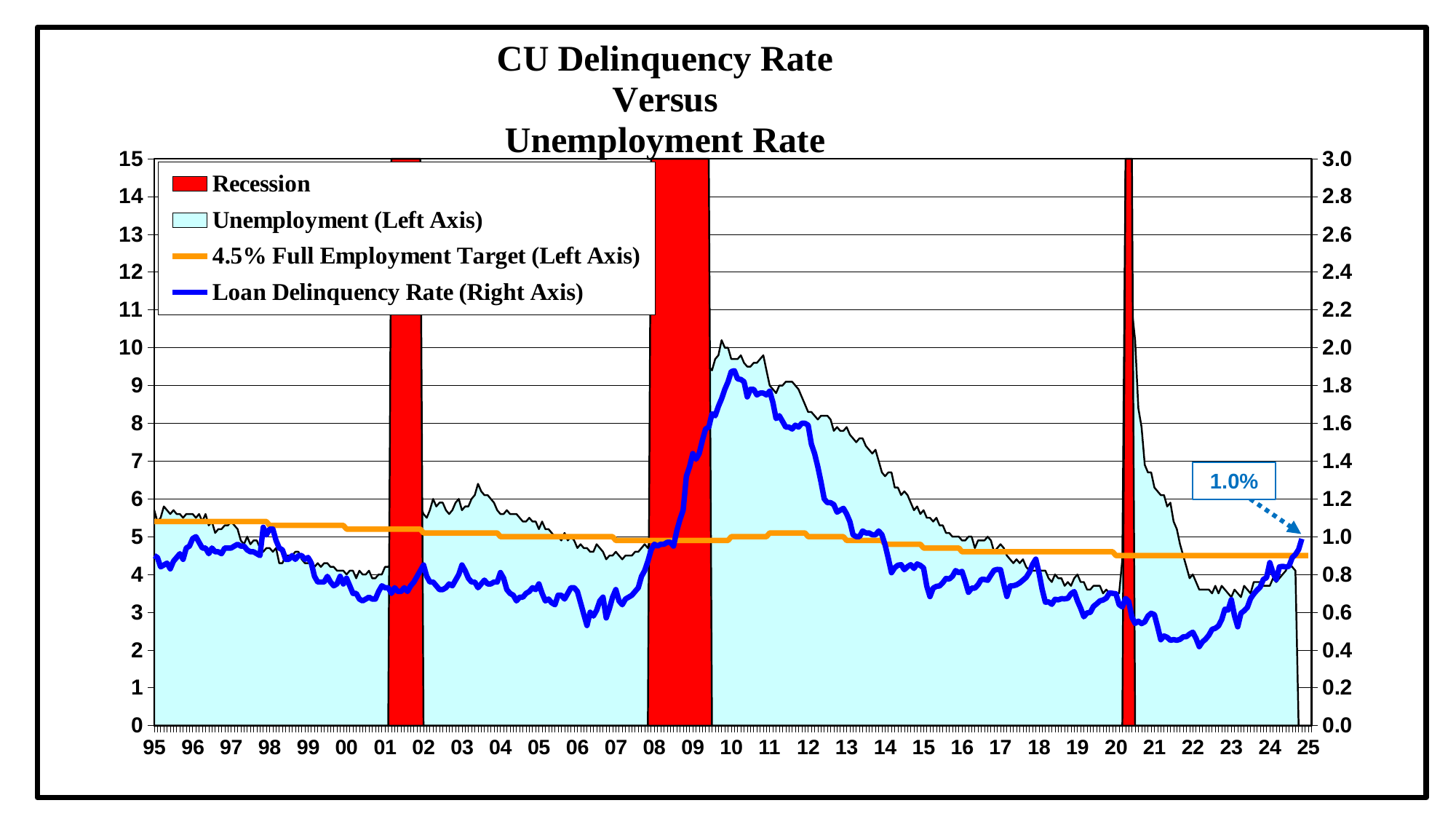
Is the Unemployment value in 2000 greater or less than 5? less What is the title of the chart? CU Delinquency Rate Versus Unemployment Rate Is the Loan Delinquency Rate in 2021 greater or less than 0.6? less Is the Unemployment value in 2010 greater or less than 8? greater How many recession periods are shaded on the chart? 3 Which axis is the Loan Delinquency Rate plotted against? Right axis Does the Unemployment series rise or fall between 2010 and 2019? fall What is the labelled value of the Loan Delinquency Rate at the end of the series (around 2024-25)? 1.0% How many series does the legend list? 4 Which is higher, the Loan Delinquency Rate in 2010 or in 2006? 2010 In which year on the x axis does the Unemployment series reach its highest point? 20